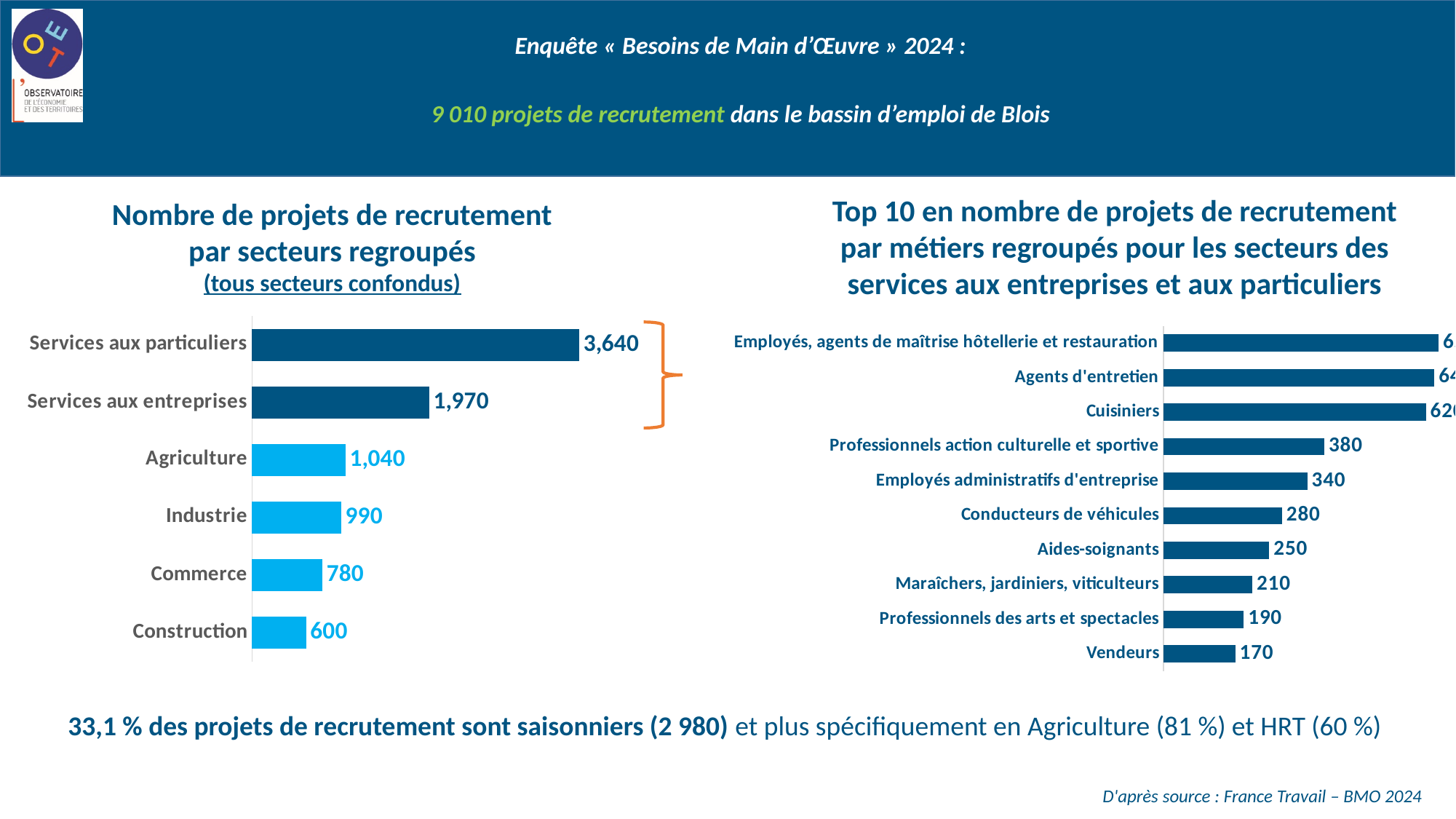
In the right chart 'Top 10 en nombre de projets de recrutement par métiers regroupés', what is the value for Conducteurs de véhicules? 280 In the right chart 'Top 10 en nombre de projets de recrutement par métiers regroupés', which métier has the lowest value? Vendeurs In the chart 'Nombre de projets de recrutement par secteurs regroupés', which sector has the lowest value? Construction In the chart 'Nombre de projets de recrutement par secteurs regroupés', what is the value for Industrie? 990 How many sectors are shown in the chart 'Nombre de projets de recrutement par secteurs regroupés'? 6 In the chart 'Nombre de projets de recrutement par secteurs regroupés', what is the difference between Services aux particuliers and Services aux entreprises? 1,670 In the right chart 'Top 10 en nombre de projets de recrutement par métiers regroupés', what is the difference between Professionnels action culturelle et sportive and Aides-soignants? 130 What kind of chart is the left chart 'Nombre de projets de recrutement par secteurs regroupés'? Bar chart In the chart 'Nombre de projets de recrutement par secteurs regroupés', which sector has the highest value? Services aux particuliers In the chart 'Nombre de projets de recrutement par secteurs regroupés', what is the value for Services aux particuliers? 3,640 In the right chart 'Top 10 en nombre de projets de recrutement par métiers regroupés', what is the value for Vendeurs? 170 In the chart 'Nombre de projets de recrutement par secteurs regroupés', which is larger: Agriculture or Industrie? Agriculture